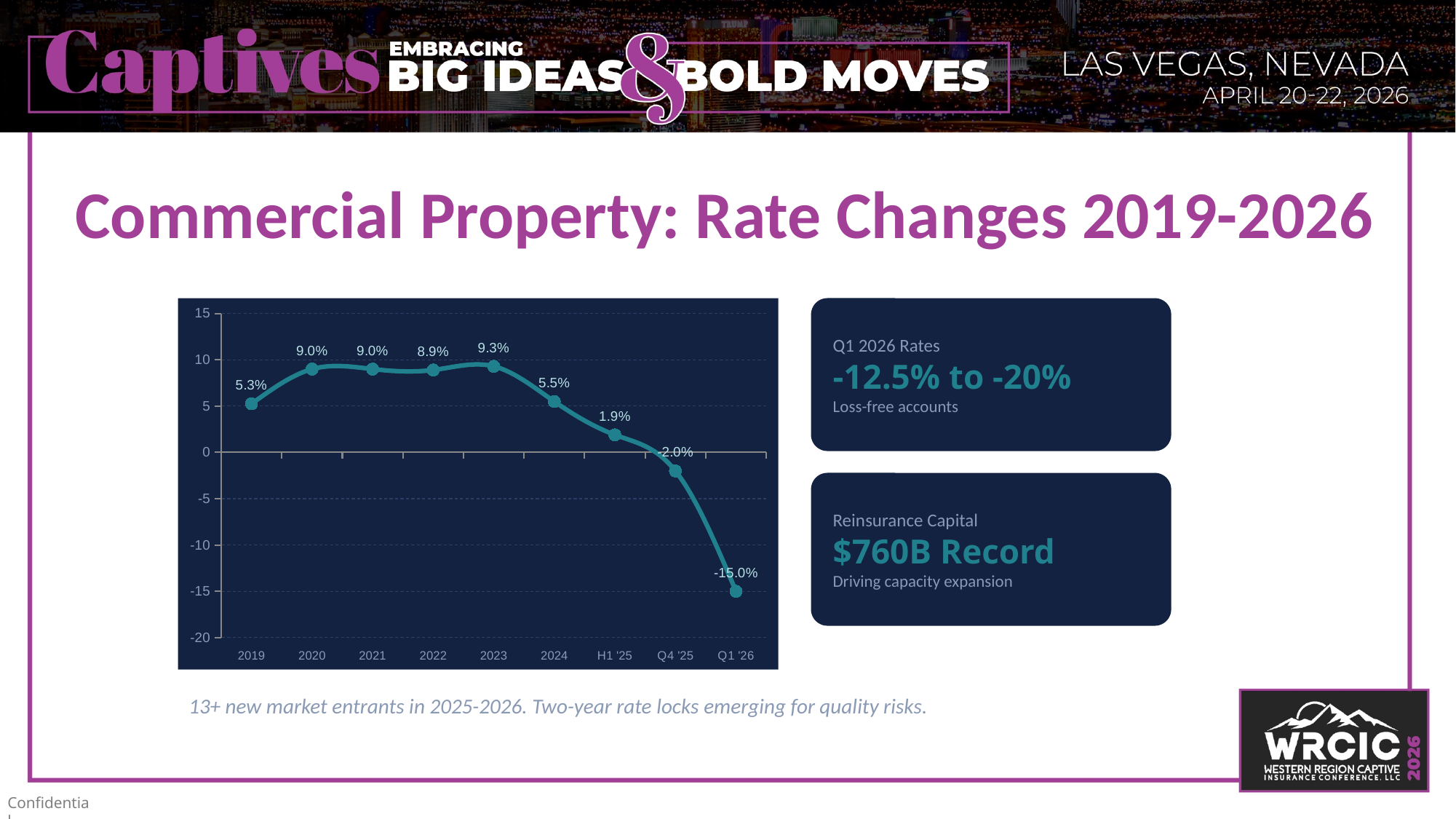
What is the rate change value for 2022? 8.9% What is the title of the slide containing the chart? Commercial Property: Rate Changes 2019-2026 Which category has the highest rate change? 2023 What is the rate change value for Q1 '26? -15.0% What kind of chart is shown on the slide? Line chart Do the values rise or fall from 2023 to Q1 '26? Fall What is the rate change value for H1 '25? 1.9% Which category has the lowest rate change? Q1 '26 What is the rate change value for 2019? 5.3% What is the difference between the rate change in 2023 and in 2024? 3.8% Which is larger, the rate change for 2020 or for 2024? 2020 How many data points are plotted on the chart? 9